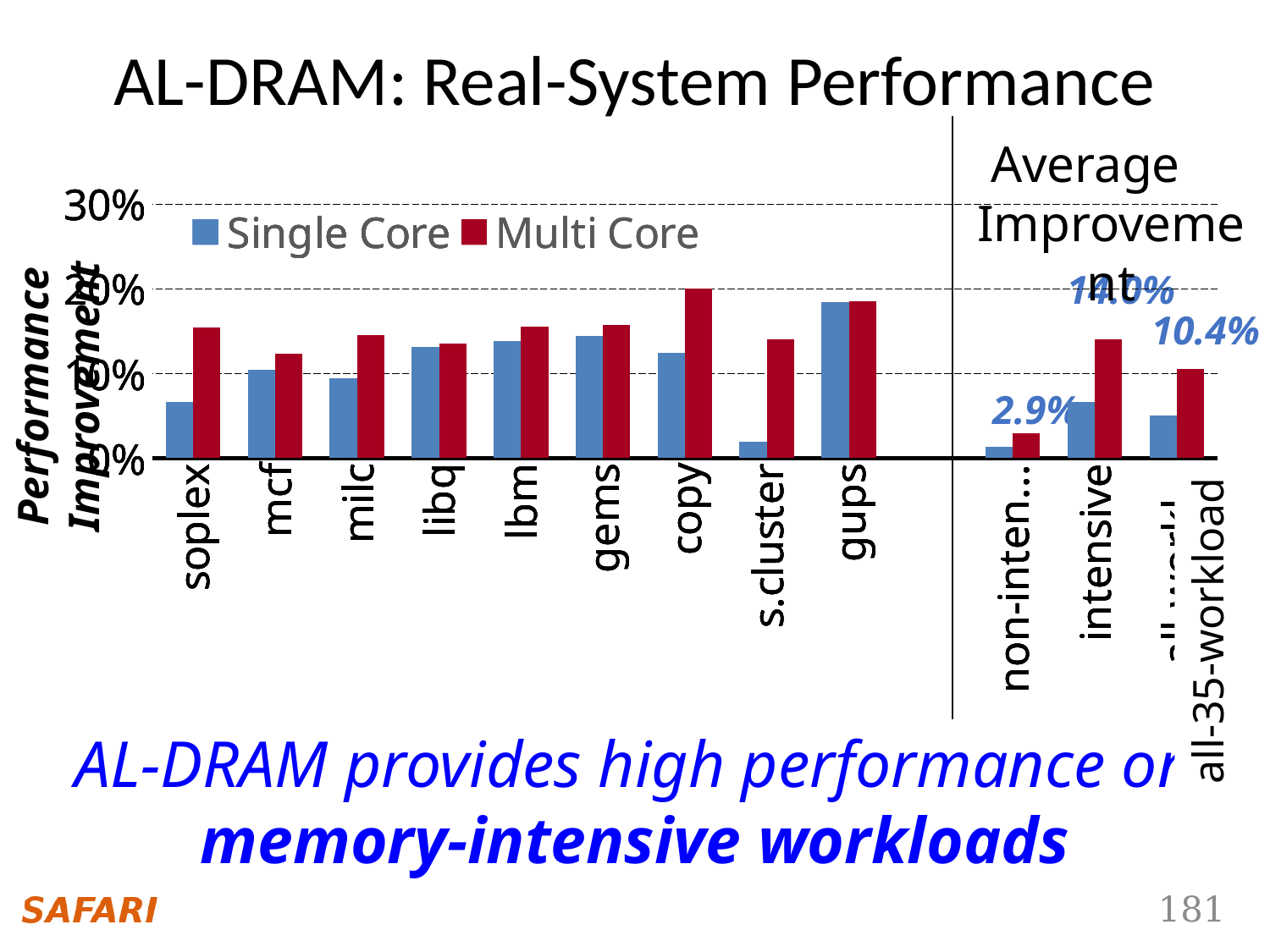
How many series does the legend list? 2 What kind of chart is shown on the slide? bar chart What is the Multi Core performance improvement for the non-intensive workload group? 2.9% What is the Multi Core performance improvement for all-35-workload? 10.4% What is the difference between the Multi Core improvement for intensive (14.0%) and all-35-workload (10.4%)? 3.6% Is the Multi Core value for copy greater or less than 10%? greater For soplex, which is larger: the Single Core or the Multi Core improvement? Multi Core What is the Multi Core performance improvement for the intensive workload group? 14.0% Among the nine benchmarks to the left of the vertical divider, which has the lowest Single Core performance improvement? s.cluster What are the two series named in the legend? Single Core and Multi Core Which benchmark has the highest Multi Core performance improvement? copy Which benchmark has the highest Single Core performance improvement? gups